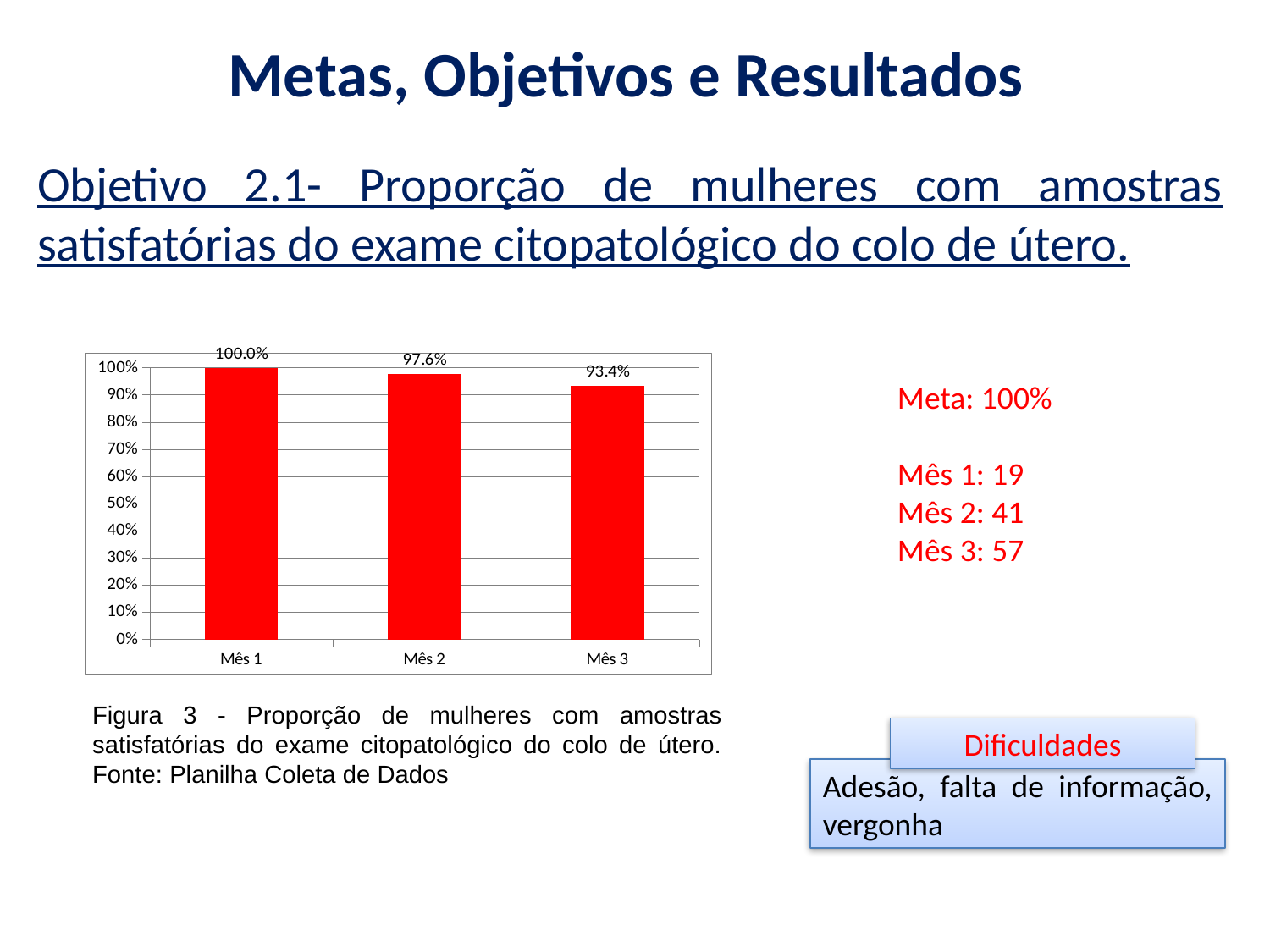
Do the values rise or fall from Mês 1 to Mês 3? fall What is the difference between the values for Mês 1 and Mês 3? 6.6% Which month has the highest value? Mês 1 What is the value for Mês 1? 100.0% How many months are shown on the x axis? 3 What kind of chart is shown? bar chart What is the value for Mês 2? 97.6% What is the difference between the values for Mês 2 and Mês 3? 4.2% Is the value for Mês 3 greater or less than 90%? greater What is the value for Mês 3? 93.4% Which is larger, the value for Mês 2 or the value for Mês 3? Mês 2 Which month has the lowest value? Mês 3